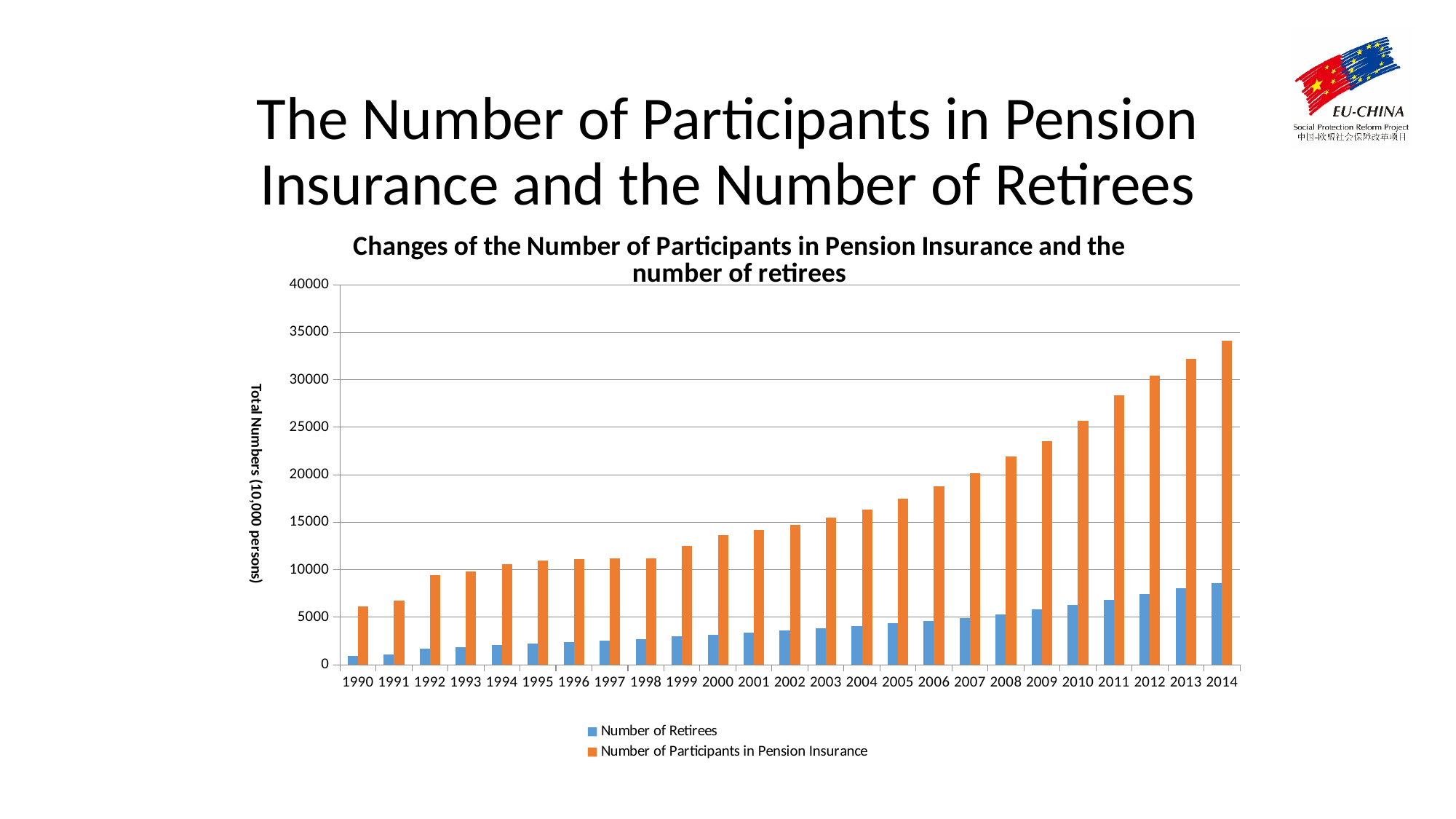
Is the Number of Retirees in 2014 greater or less than 10000? less Do the values for the Number of Participants in Pension Insurance rise or fall from 1990 to 2014? rise Is the Number of Participants in Pension Insurance in 2014 greater or less than 30000? greater What kind of chart is shown on the slide? bar chart How many years are shown on the x axis? 25 Is the Number of Participants in Pension Insurance in 2011 greater or less than 25000? greater In which year is the Number of Retirees lowest? 1990 Which is larger in 2014, the Number of Retirees or the Number of Participants in Pension Insurance? Number of Participants in Pension Insurance In which year is the Number of Participants in Pension Insurance highest? 2014 How many series does the legend list? 2 What is the label of the y axis? Total Numbers (10,000 persons)